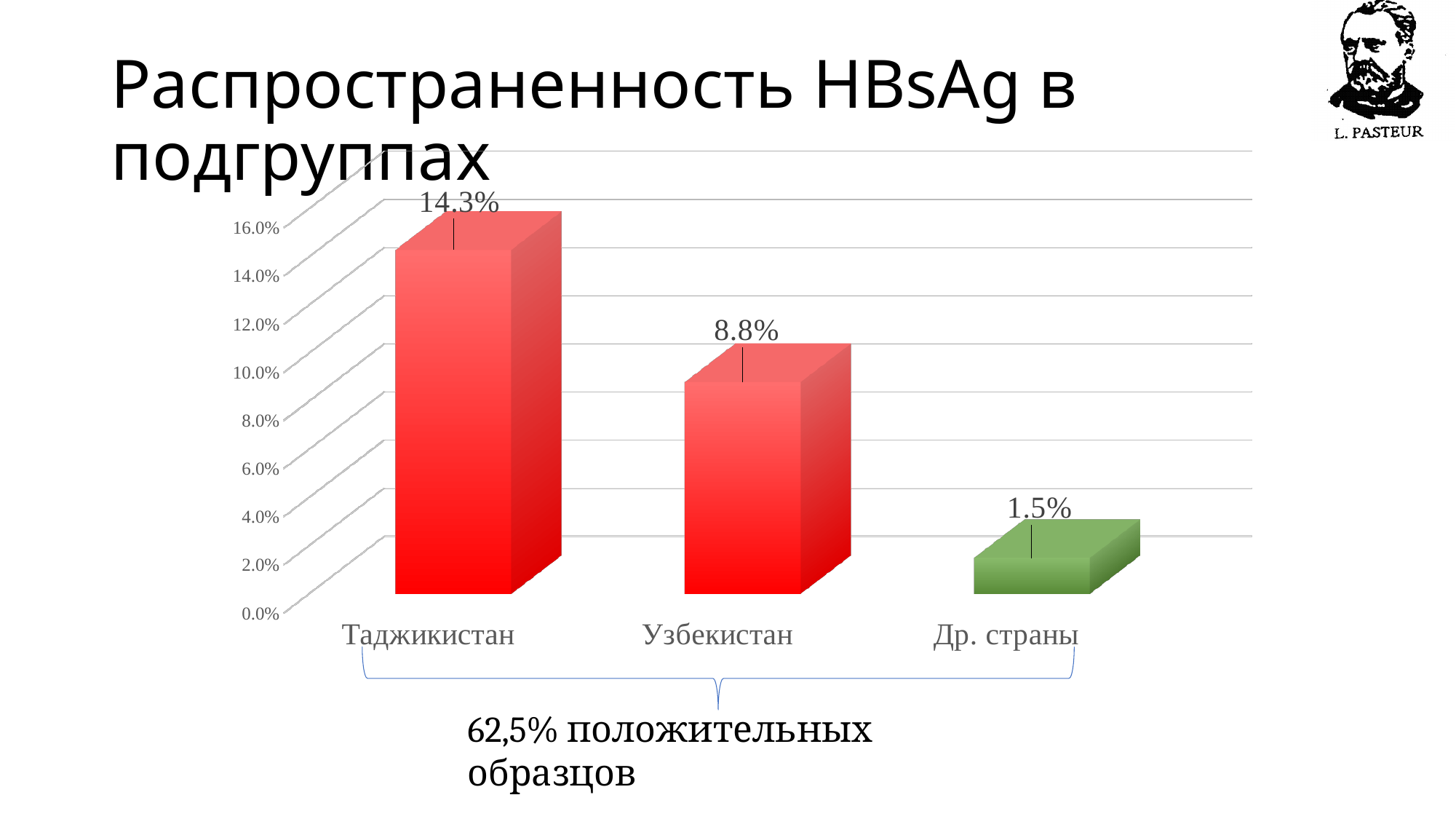
What is the difference between the values for Узбекистан and Др. страны? 7.3% What is the difference between the values for Таджикистан and Узбекистан? 5.5% Is the value for Узбекистан greater or less than 10.0%? less Which category has the lowest value? Др. страны Do the values rise or fall from left to right along the x axis? fall What kind of chart is shown on the slide? bar chart Which is larger, the value for Узбекистан or the value for Др. страны? Узбекистан Which category has the highest value? Таджикистан How many categories are shown on the x axis? 3 What is the value for Таджикистан? 14.3% What is the value for Узбекистан? 8.8% What is the value for Др. страны? 1.5%